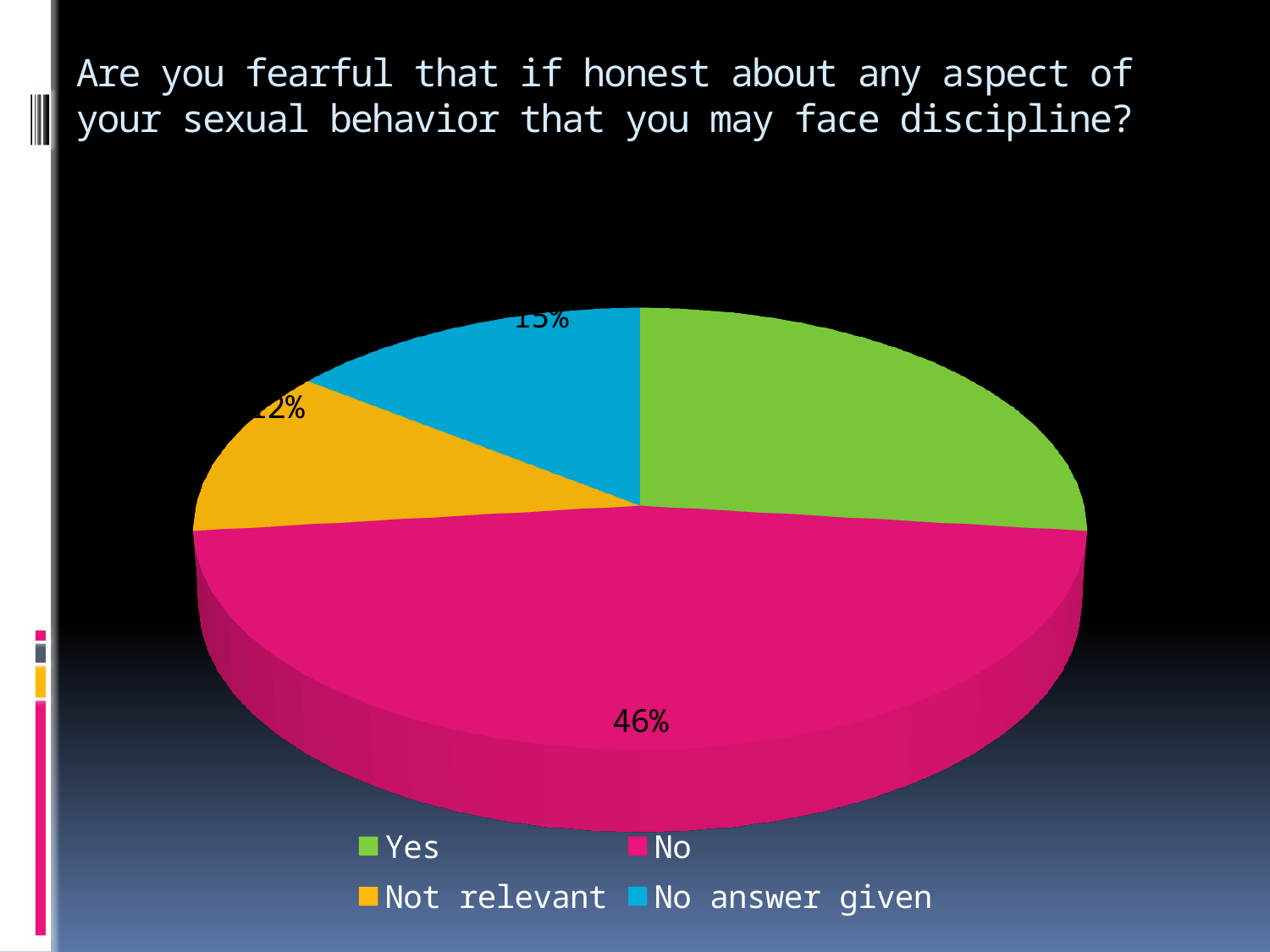
Which category is shown in green in the pie chart? Yes What kind of chart is shown on the slide? pie chart What share of the pie does the "No" slice represent? 46% Which is larger, the "Yes" slice or the "No answer given" slice? Yes Which category has the largest slice of the pie? No How many categories does the pie chart have? 4 What question is the chart's title asking? Are you fearful that if honest about any aspect of your sexual behavior that you may face discipline? Which is larger, the "Yes" slice or the "Not relevant" slice? Yes Which is larger, the "Yes" slice or the "No" slice? No How many entries does the legend list? 4 What percentage of respondents answered "No"? 46%